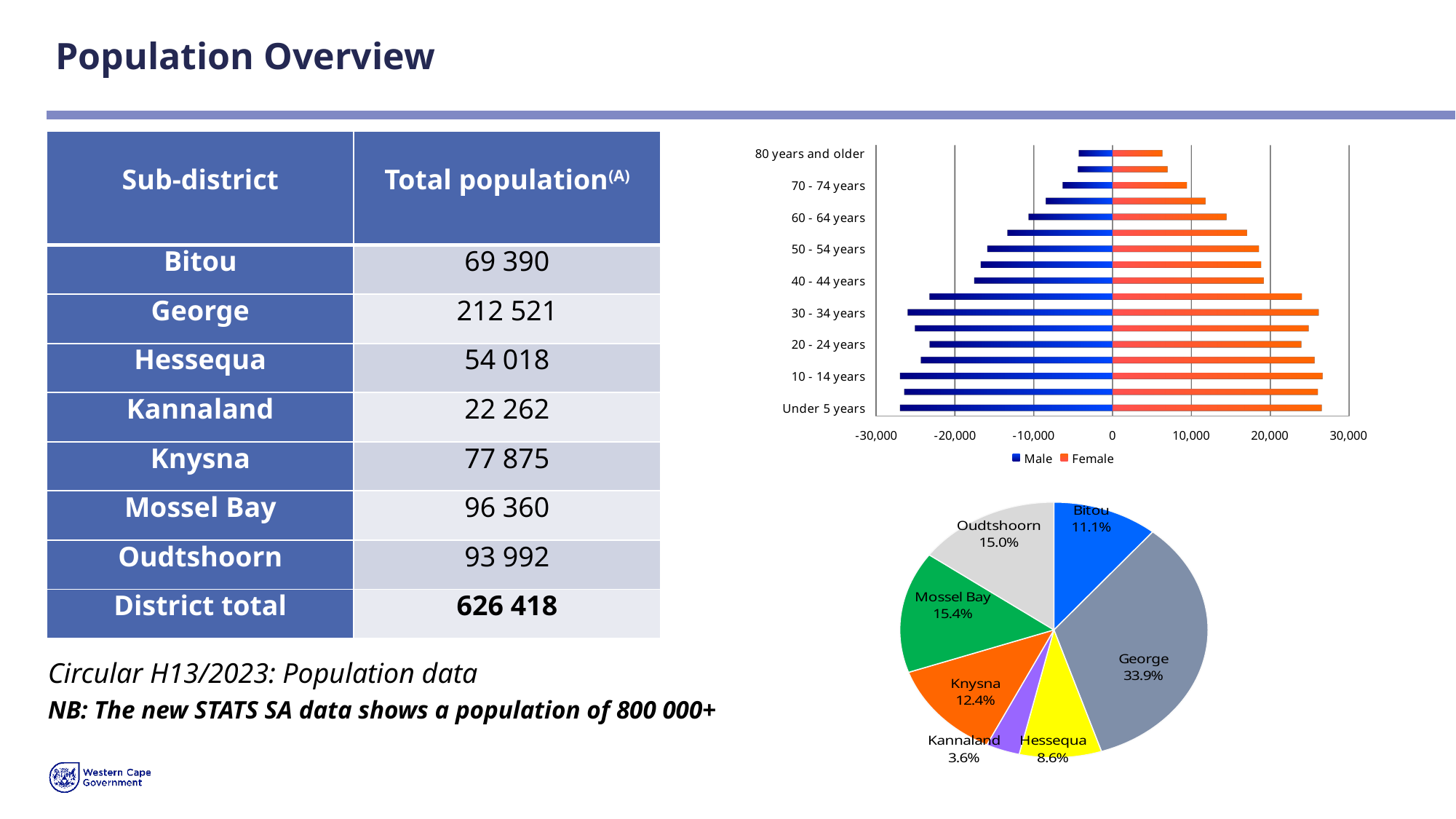
How many series does the legend of the age-group chart list? 2 In the pie chart, what share does Kannaland have? 3.6% In the pie chart, which has the larger share, Mossel Bay or Oudtshoorn? Mossel Bay In the age-group chart, is the Female value for 30 - 34 years greater or less than 20,000? greater In the pie chart, which sub-district has the smallest share? Kannaland What kind of chart is the chart at the bottom right of the slide? Pie chart In the pie chart, what share does George have? 33.9% How many slices does the pie chart have? 7 In the pie chart, what is the difference between the shares of George and Bitou? 22.8% In the pie chart, which sub-district has the largest share? George In the age-group chart, is the Female value for 80 years and older greater or less than 10,000? less What kind of chart is the chart at the top right of the slide showing age groups? Bar chart